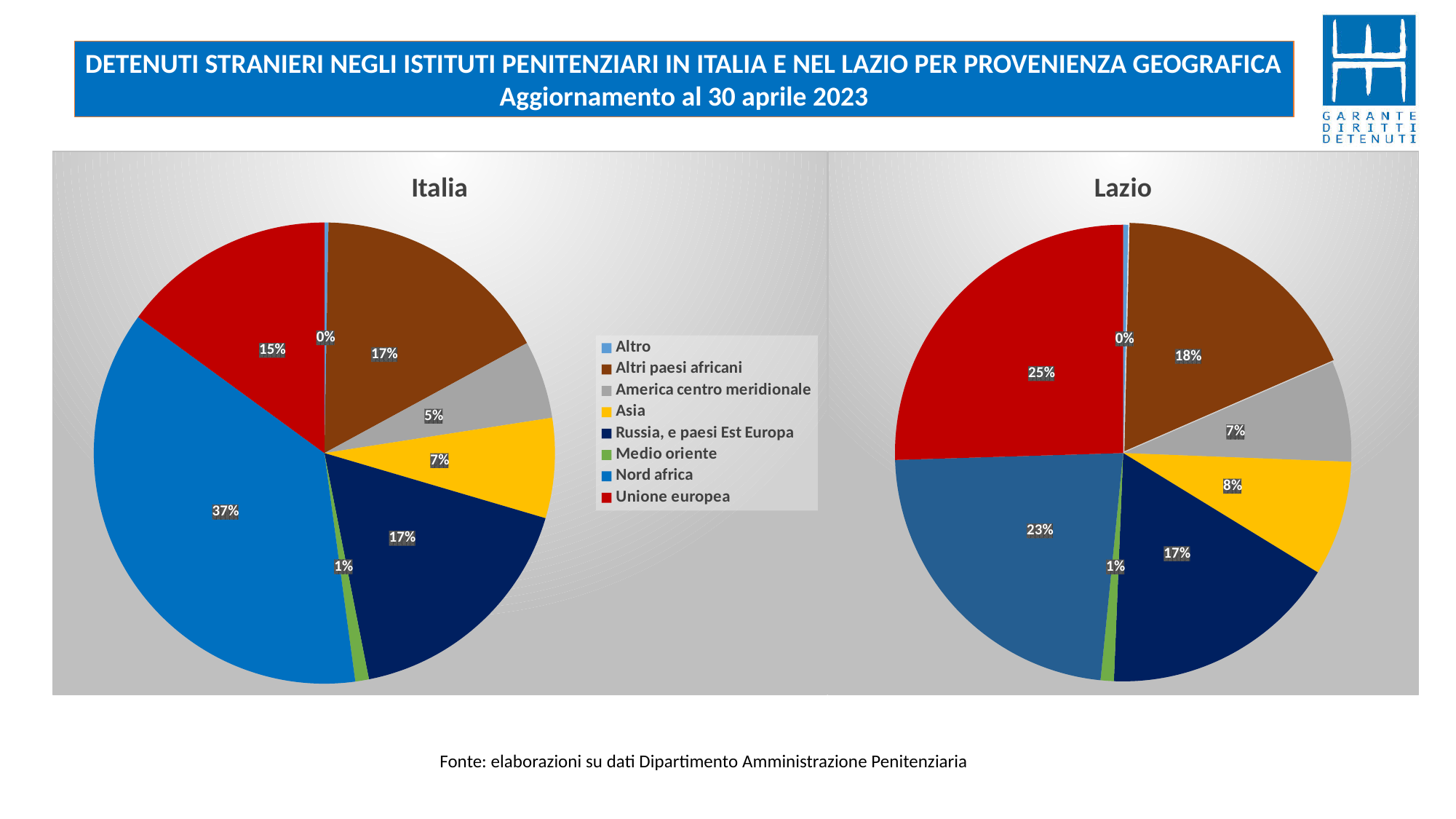
What is the difference between the Nord africa share in the Italia chart and the Nord africa share in the Lazio chart? 14 percentage points In the Lazio chart, which is larger: the share for Asia or the share for America centro meridionale? Asia In the Italia chart, what is the combined share of Asia and Medio oriente? 8% In the Italia chart, what is the share for America centro meridionale? 5% In the Italia chart, which category has the smallest share? Altro In the Italia chart, which category has the largest share? Nord africa In the Lazio chart, what is the share for Altri paesi africani? 18% In the Lazio chart, which category has the largest share? Unione europea In the Italia chart, what share of foreign detainees comes from Nord africa? 37% What type of chart is used for the Italia and Lazio data? Pie chart How many categories does the legend list? 8 In the Lazio chart, what share of foreign detainees comes from Unione europea? 25%